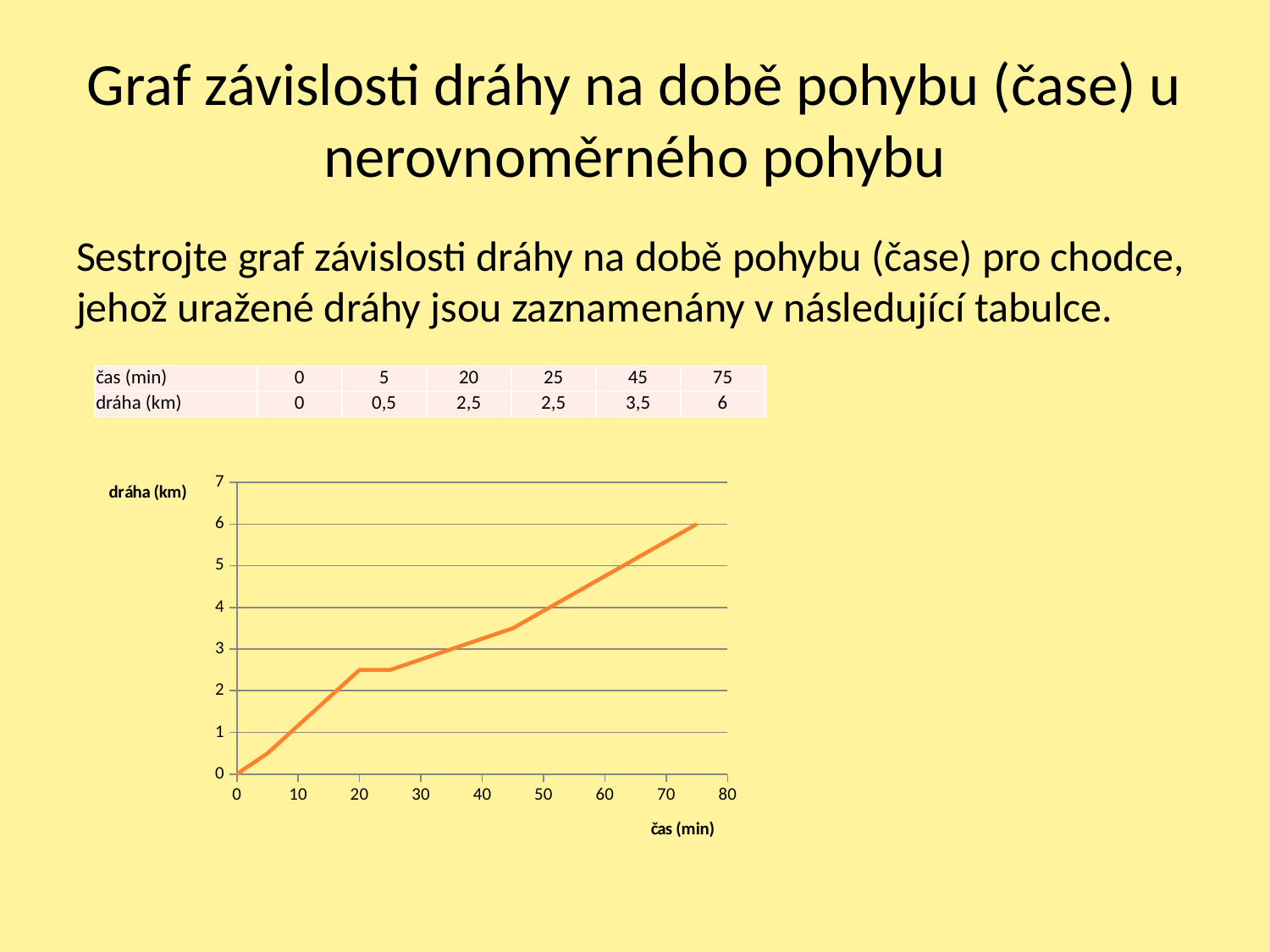
What kind of chart is shown on the slide? line chart Which has the larger dráha (km): čas 25 min or čas 45 min? 45 min At which čas (min) is dráha (km) the highest? 75 What is the label of the y axis of the chart? dráha (km) How many data points are plotted on the chart? 6 What is the label of the x axis of the chart? čas (min) Is the value of dráha (km) at čas 45 min greater or less than 3? greater What is the value of dráha (km) at čas 5 min? 0,5 What is the value of dráha (km) at čas 20 min? 2,5 Does dráha (km) rise or fall as čas (min) increases along the x axis? rise What is the difference in dráha (km) between čas 75 min and čas 45 min? 2,5 What is the value of dráha (km) at čas 75 min? 6